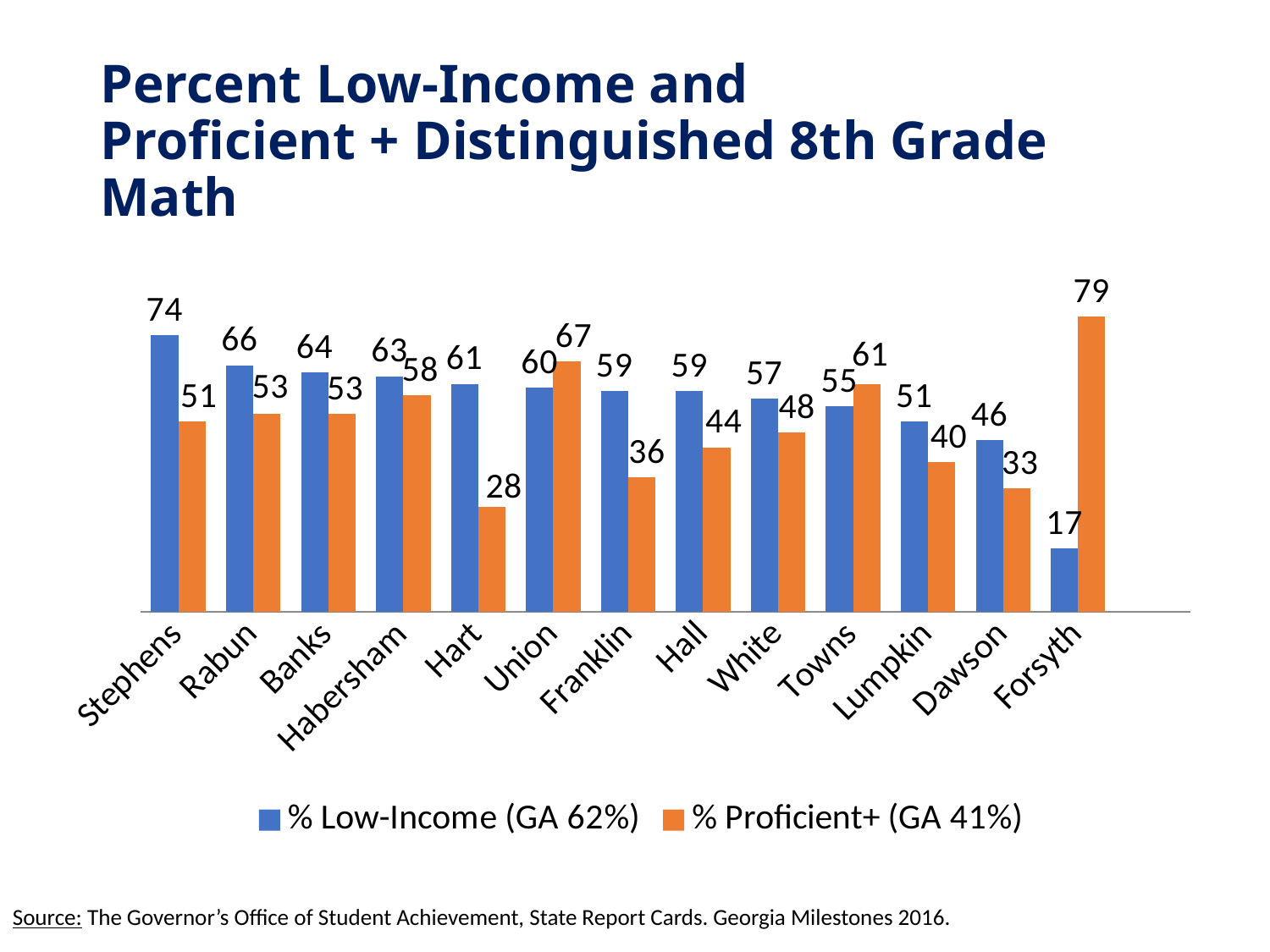
How many counties are shown on the x axis of the chart? 13 What is the % Proficient+ value for Forsyth? 79 Which county has the highest % Low-Income value? Stephens What is the % Proficient+ value for Hart? 28 What is the % Low-Income value for Stephens? 74 What is the difference between the % Low-Income and % Proficient+ values for Franklin? 23 Which county has the lowest % Proficient+ value? Hart What Georgia statewide percentage is given in the legend for % Proficient+? 41% Does the % Low-Income value generally rise or fall from Stephens to Forsyth? fall How many series does the legend list? 2 What type of chart is shown on the slide? bar chart Which is larger for Union, the % Low-Income value or the % Proficient+ value? % Proficient+